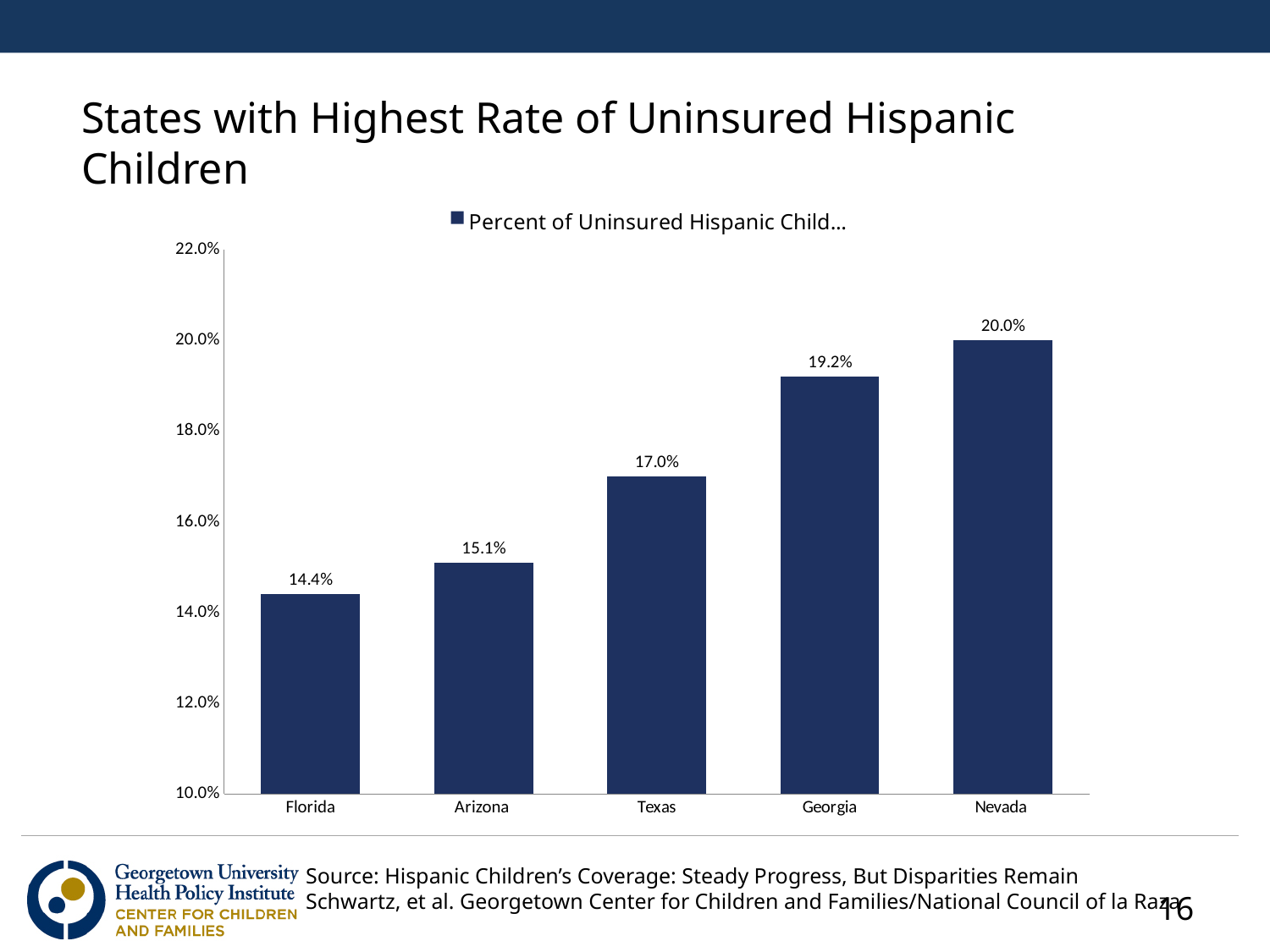
What kind of chart is shown on the slide? Bar chart What is the percent of uninsured Hispanic children in Texas? 17.0% Which has a higher value, Arizona or Texas? Texas What is the value shown for Florida? 14.4% Do the values rise or fall from Florida to Nevada along the x axis? Rise How many states are shown in the chart? 5 What is the value shown for Georgia? 19.2% Which state has the lowest rate of uninsured Hispanic children? Florida What is the difference between the values for Nevada and Florida? 5.6% Is the value for Georgia greater or less than 18.0%? greater What is the difference between the values for Georgia and Texas? 2.2% Which state has the highest rate of uninsured Hispanic children? Nevada